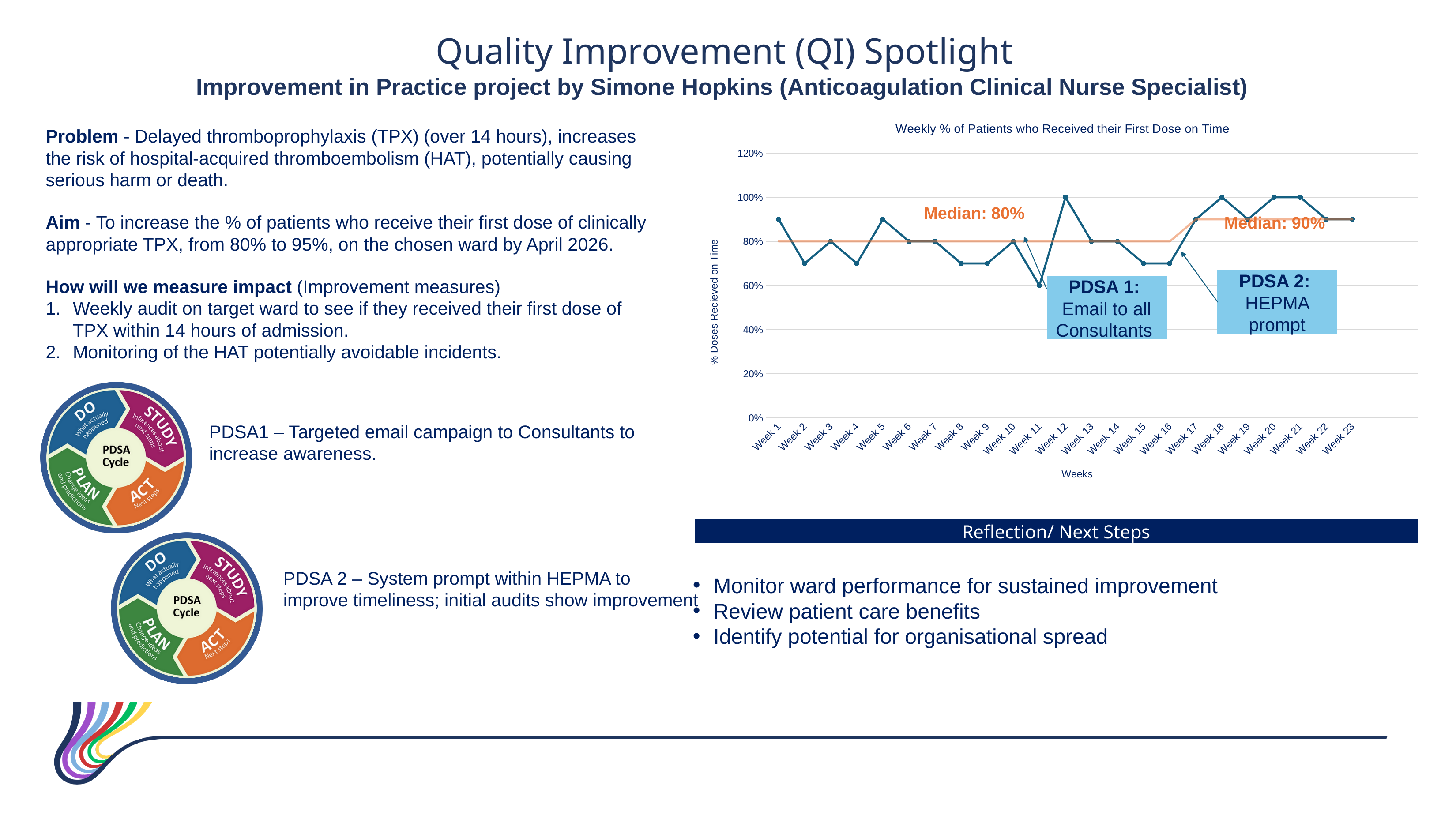
Which week has the lowest value in the chart? Week 11 What is the value for Week 12 in the chart? 100% Which is larger, the value for Week 12 or the value for Week 11? Week 12 Is the value for Week 18 greater or less than 80%? greater What is the value for Week 11 in the chart? 60% What kind of chart is shown on the slide? line chart How many weeks are plotted on the x axis of the chart? 23 What is the median value shown for the earlier part of the chart, before PDSA 2? Median: 80% Is the value for Week 2 greater or less than 80%? less What is the title of the chart? Weekly % of Patients who Received their First Dose on Time What is the value for Week 3 in the chart? 80% What is the median value shown for the later part of the chart, after PDSA 2? Median: 90%